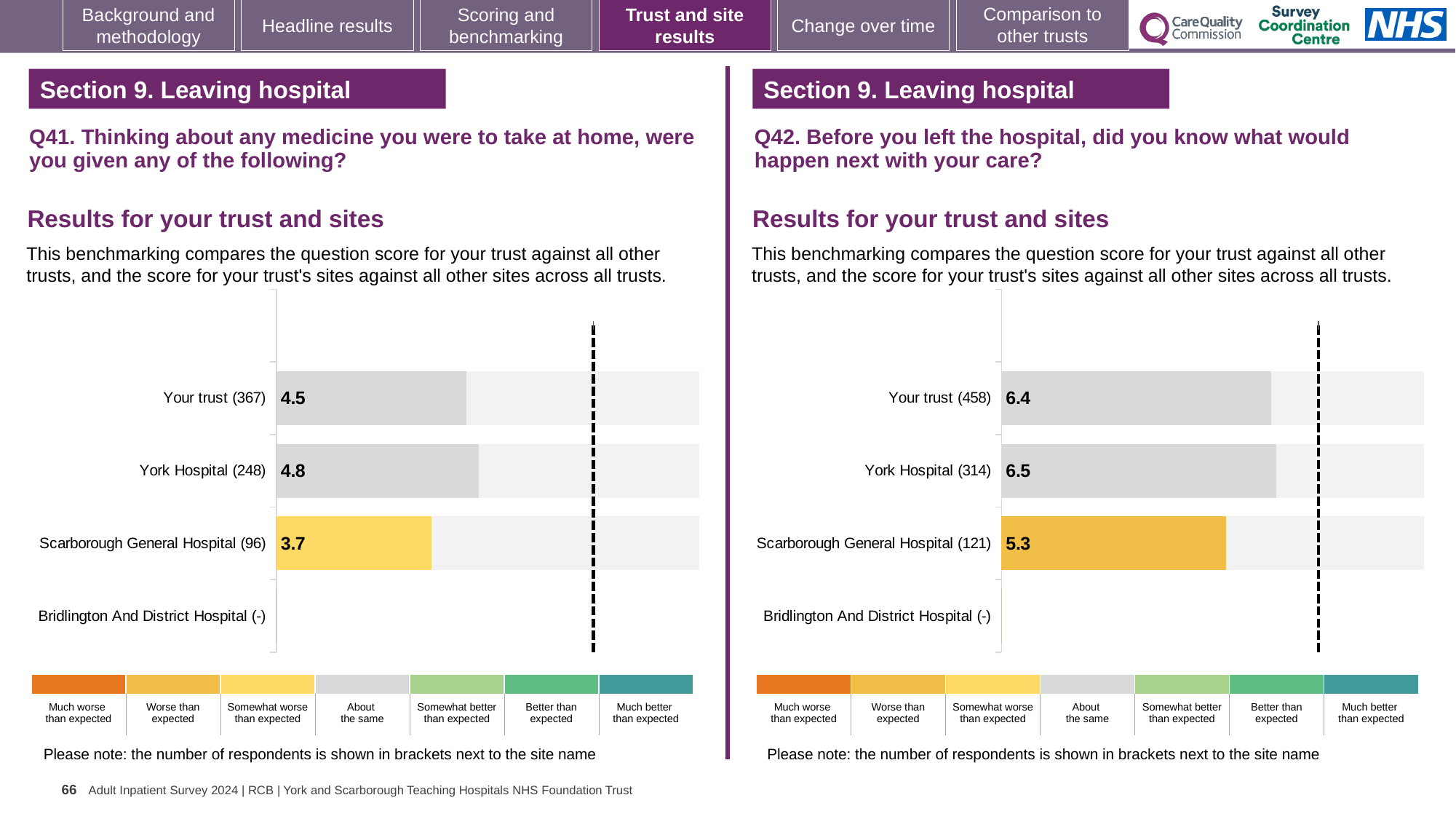
In the Q42 chart on the right, which site or trust has the lowest score? Scarborough General Hospital In the Q42 chart on the right, which has the larger score, Your trust or Scarborough General Hospital? Your trust In the Q42 chart on the right, what is the score for York Hospital? 6.5 In the Q41 chart on the left, which site or trust has the highest score? York Hospital What kind of chart is used in the Q41 chart on the left? Bar chart In the Q41 chart on the left, what is the difference between the York Hospital score and the Scarborough General Hospital score? 1.1 In the Q42 chart on the right, what is the difference between the Your trust score and the Scarborough General Hospital score? 1.1 How many respondents are shown in brackets for Your trust in the Q42 chart on the right? 458 In the Q42 chart on the right, what is the score for Scarborough General Hospital? 5.3 In the Q41 chart on the left, what is the score for Scarborough General Hospital? 3.7 In the Q41 chart on the left, what colour category does the Scarborough General Hospital bar fall into according to the legend? Somewhat worse than expected In the Q41 chart on the left, what is the score for Your trust? 4.5